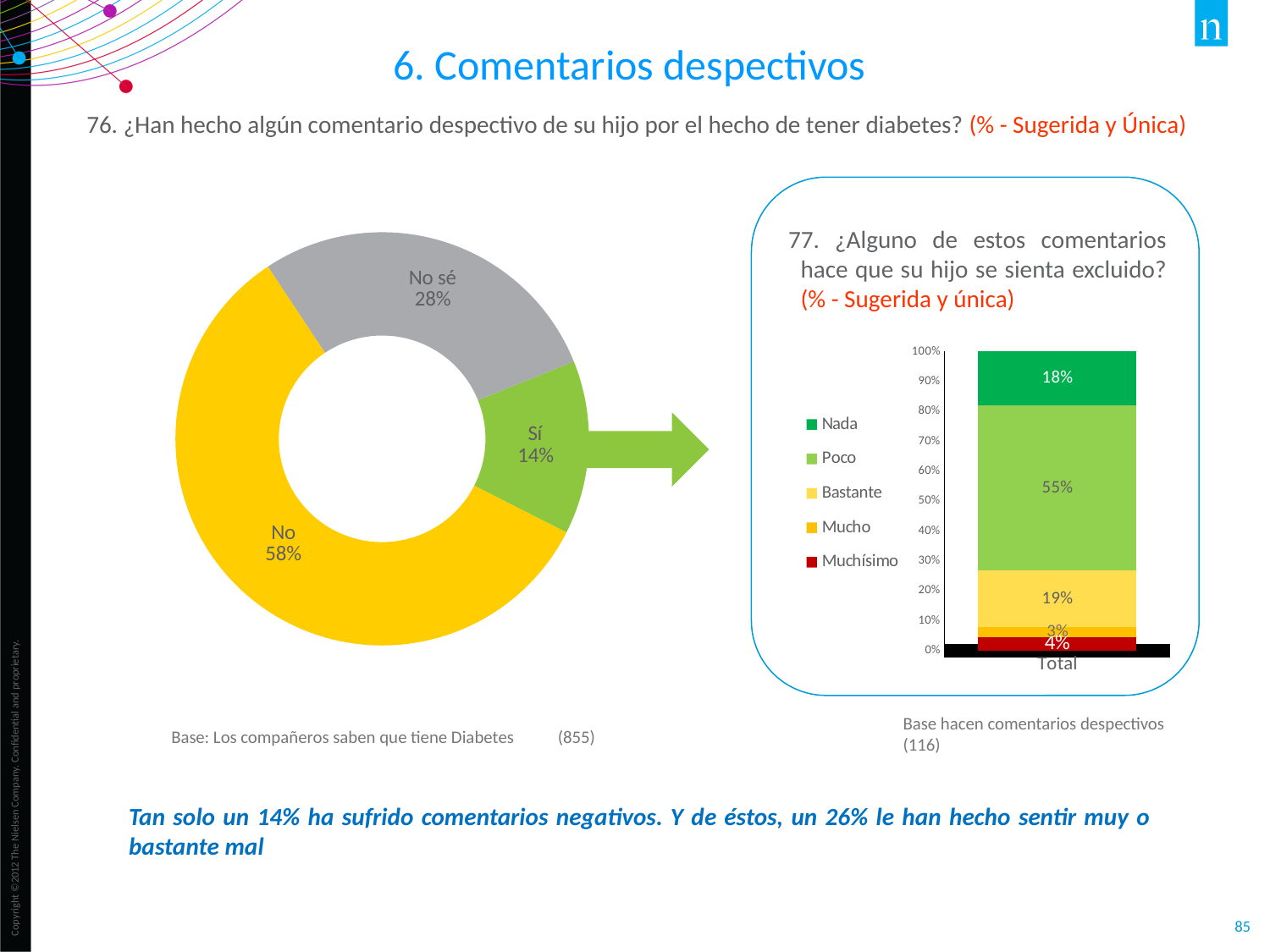
In the stacked bar chart on the right, which is larger, "Bastante" or "Nada"? Bastante How many series does the legend of the stacked bar chart on the right list? 5 In the stacked bar chart on the right, what percentage is shown for "Nada"? 18% In the donut chart on the left, which category has the largest share? No In the donut chart on the left, what percentage is shown for "No"? 58% What kind of chart is the chart on the left of the slide? Donut (pie) chart In the donut chart on the left, which category has the smallest share? Sí In the stacked bar chart on the right, what percentage is shown for "Poco"? 55% How many categories are shown in the donut chart on the left? 3 In the stacked bar chart on the right, which series has the largest segment? Poco In the donut chart on the left, what percentage is shown for "Sí"? 14% In the donut chart on the left, what is the difference in percentage points between "No" and "No sé"? 30